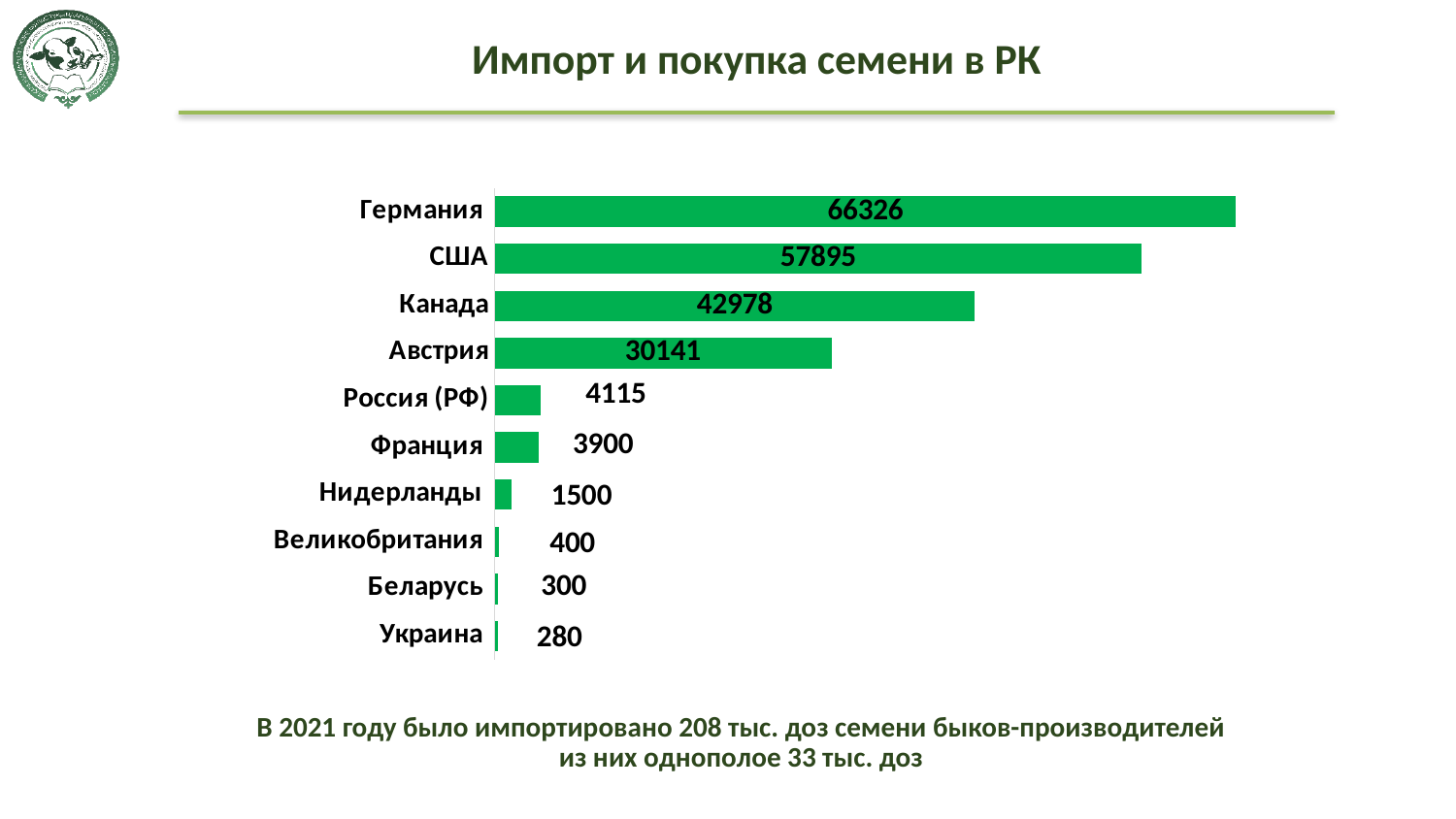
What is the value for Нидерланды? 1500 What colour are the bars in the chart? green Which is larger, the value for Канада or the value for Австрия? Канада What kind of chart is shown on the slide? bar chart How many countries are shown in the chart? 10 What is the title of the slide? Импорт и покупка семени в РК Which country has the lowest value? Украина What is the difference between the values for Германия and США? 8431 What is the value for Германия? 66326 What is the value for Канада? 42978 What is the difference between the values for Россия (РФ) and Франция? 215 Which country has the highest value? Германия